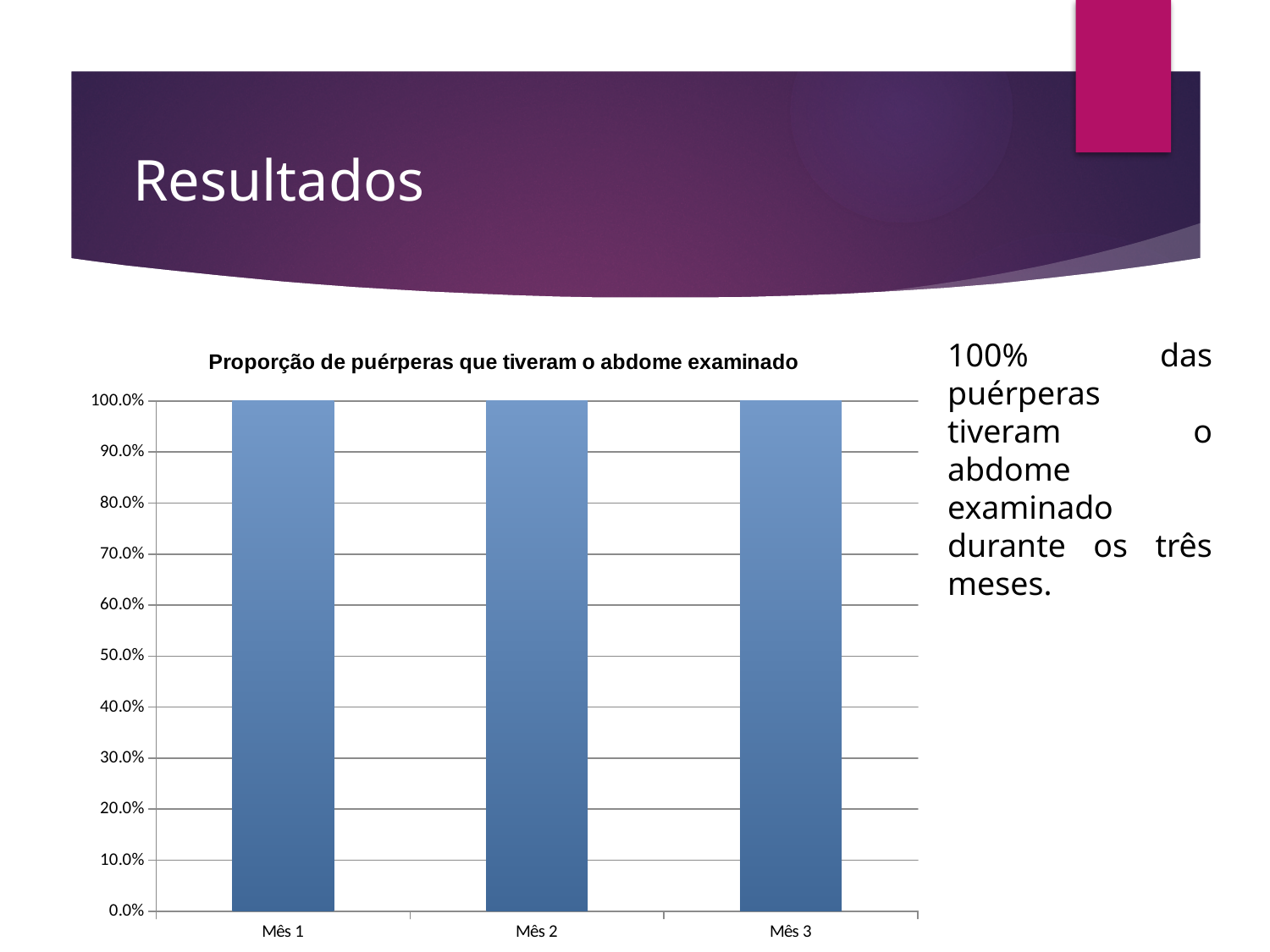
Do the values rise, fall, or stay the same from Mês 1 to Mês 3? stay the same What is the value for Mês 3? 100.0% Is the value for Mês 2 greater or less than 50.0%? greater What is the value for Mês 1? 100.0% What is the value for Mês 2? 100.0% What is the title of the chart? Proporção de puérperas que tiveram o abdome examinado What is the label of the first category on the x axis? Mês 1 What kind of chart is shown on the slide? bar chart Is the value for Mês 3 greater or less than 90.0%? greater How many categories are plotted on the x axis of the chart? 3 What is the difference between the values for Mês 1 and Mês 3? 0.0%